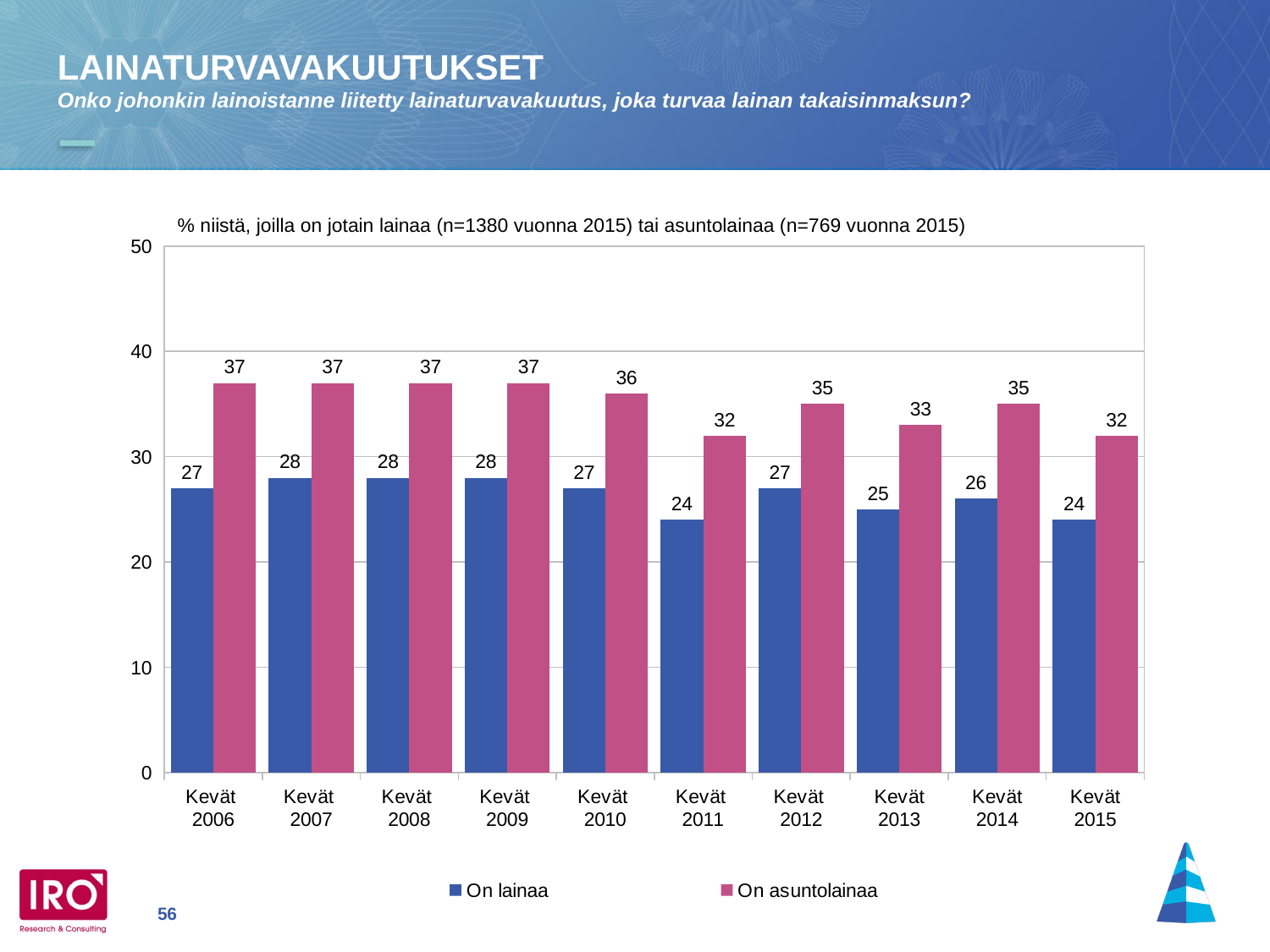
Does the value for "On asuntolainaa" rise or fall from Kevät 2009 to Kevät 2011? Fall What kind of chart is shown on the slide? Bar chart What is the value for "On lainaa" in Kevät 2014? 26 What is the value for "On asuntolainaa" in Kevät 2010? 36 Which year has the lowest value for "On asuntolainaa"? Kevät 2011 and Kevät 2015 (both 32) Which is larger in Kevät 2012: "On lainaa" or "On asuntolainaa"? On asuntolainaa What colour are the bars for "On asuntolainaa"? Pink/magenta How many series does the legend list? 2 What is the value for "On lainaa" in Kevät 2011? 24 How many time periods are shown on the x axis? 10 What is the value for "On asuntolainaa" in Kevät 2013? 33 What is the difference between "On asuntolainaa" and "On lainaa" in Kevät 2015? 8